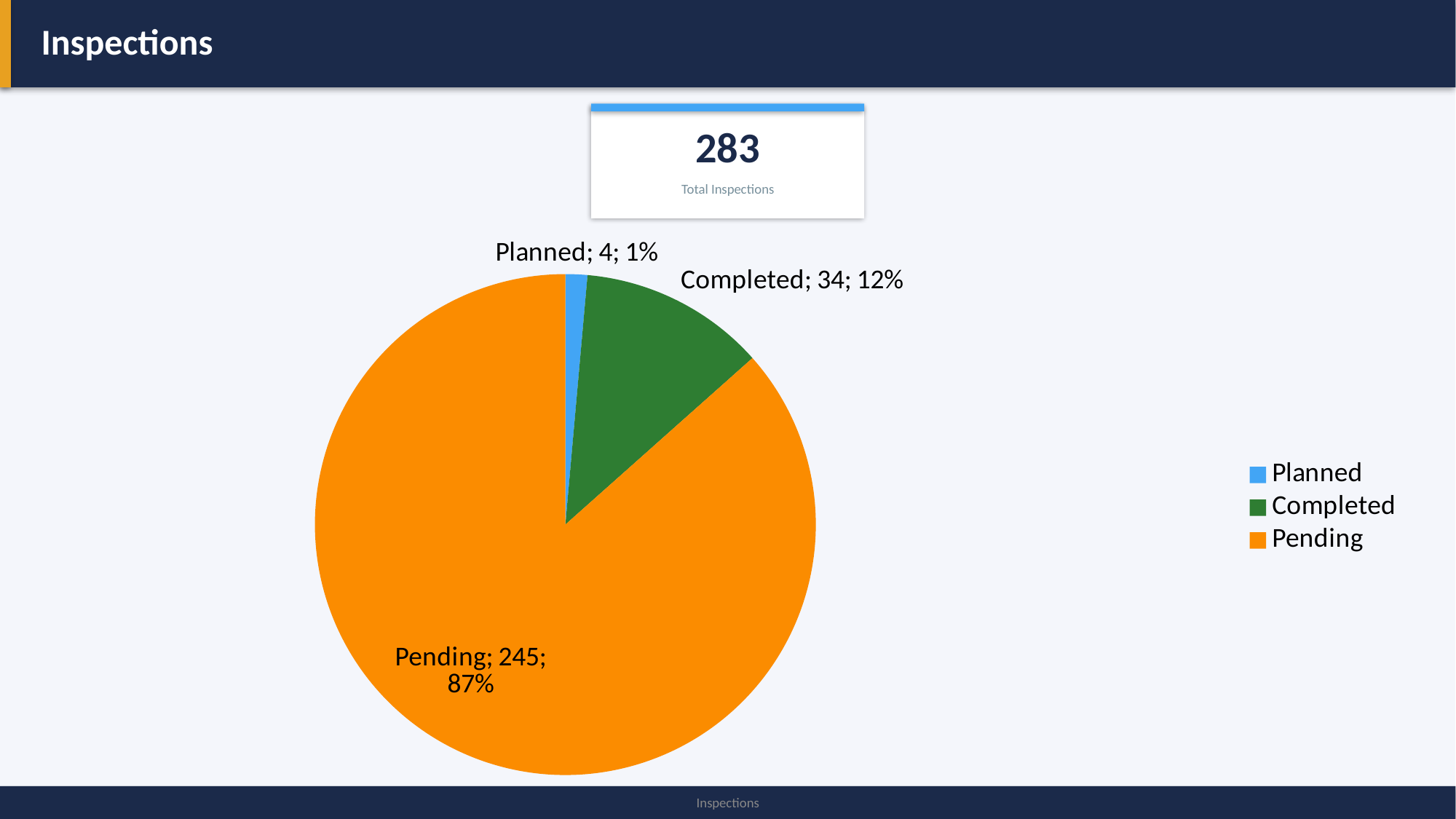
What kind of chart is shown on the slide? pie chart How many inspections are Completed? 34 How many inspections are Pending? 245 What colour is the Pending slice? orange Which category has the largest slice? Pending How many categories does the pie chart have? 3 What share of the pie does the Completed slice represent? 12% What share of the pie does the Pending slice represent? 87% How many inspections are Planned? 4 Which category has the smallest slice? Planned What is the difference between the Pending and Completed counts? 211 Which is larger, Completed or Planned? Completed